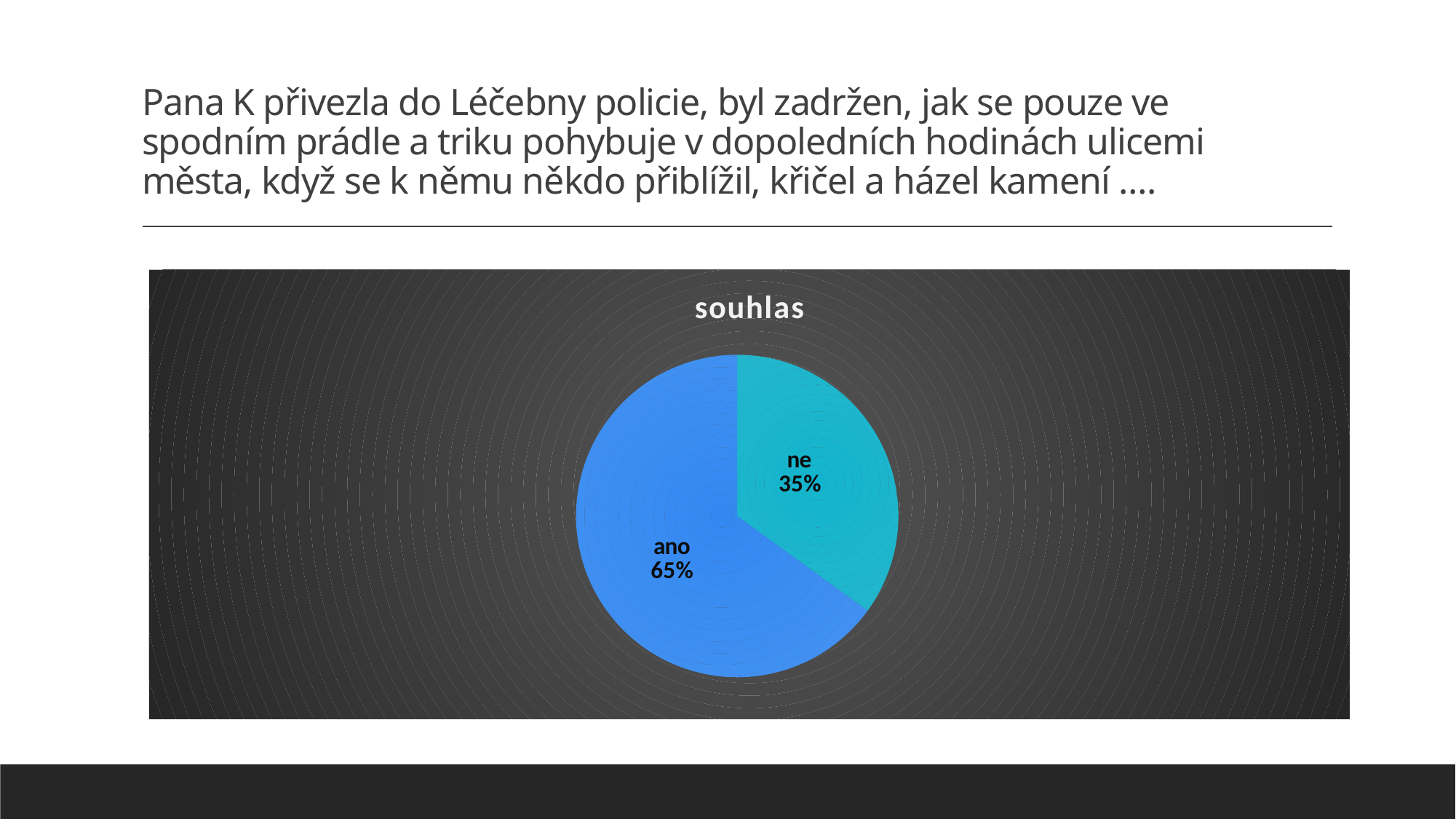
Which slice is the largest in the pie chart? ano What is the difference in percentage points between the "ano" and "ne" slices? 30 What colour is the "ne" slice? teal What is the title of the chart? souhlas Which is larger, the "ano" slice or the "ne" slice? ano What kind of chart is shown on the slide? pie chart Which slice is the smallest in the pie chart? ne What share of the pie does the "ano" slice represent? 65% What share of the pie does the "ne" slice represent? 35% How many slices does the pie chart have? 2